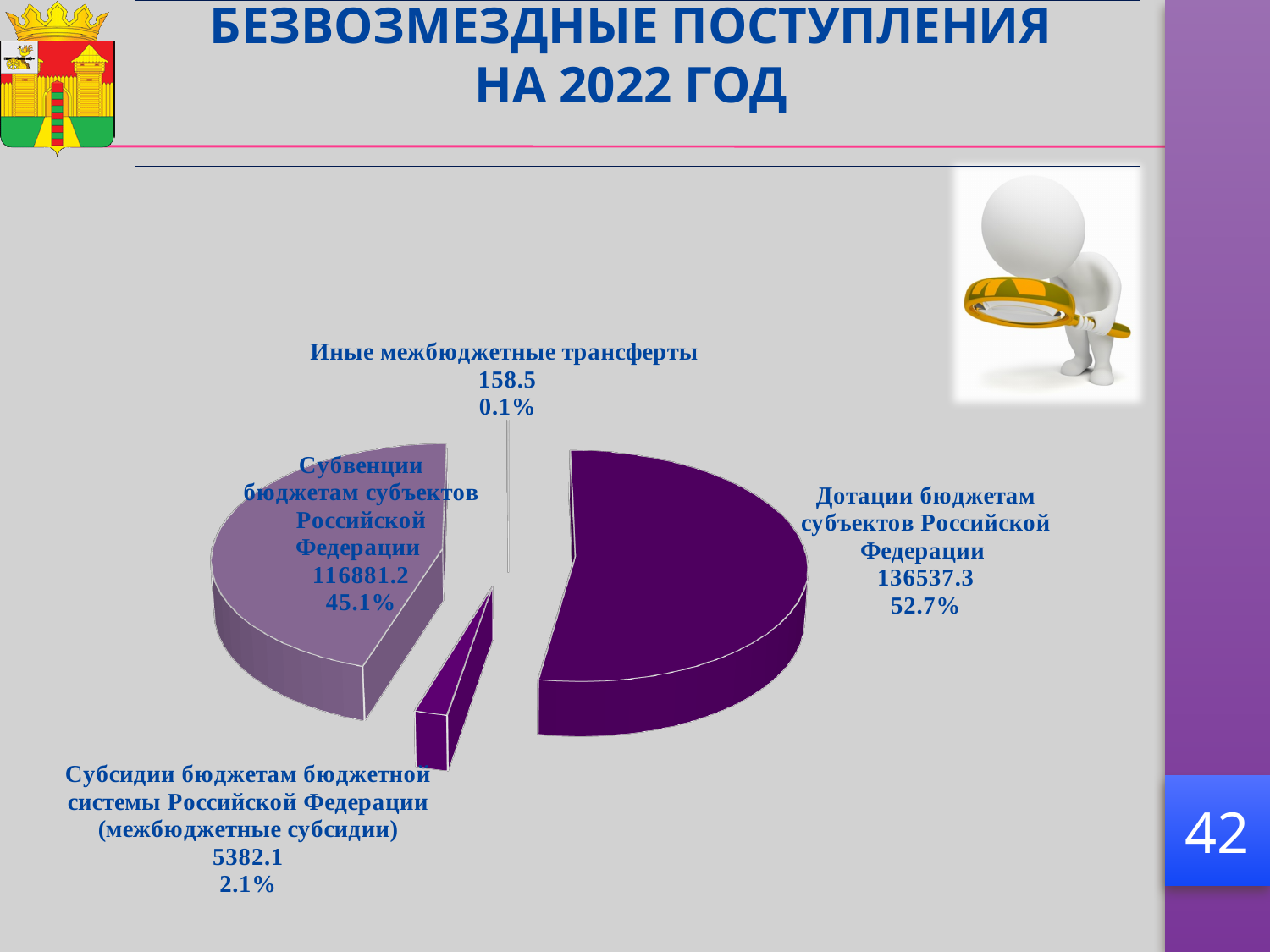
Which is larger: the value for Субсидии бюджетам бюджетной системы Российской Федерации (межбюджетные субсидии) or Иные межбюджетные трансферты? Субсидии бюджетам бюджетной системы Российской Федерации (межбюджетные субсидии) What is the difference between the values for Дотации бюджетам субъектов Российской Федерации and Субвенции бюджетам субъектов Российской Федерации? 19656.1 Which category has the largest slice of the pie? Дотации бюджетам субъектов Российской Федерации How many slices does the pie chart have? 4 What share of the pie does Иные межбюджетные трансферты represent? 0.1% What is the value for Дотации бюджетам субъектов Российской Федерации? 136537.3 Which category has the smallest slice of the pie? Иные межбюджетные трансферты What kind of chart is shown on the slide? pie chart What is the value for Субсидии бюджетам бюджетной системы Российской Федерации (межбюджетные субсидии)? 5382.1 What share of the pie does Субвенции бюджетам субъектов Российской Федерации represent? 45.1% What is the title of the slide containing the pie chart? БЕЗВОЗМЕЗДНЫЕ ПОСТУПЛЕНИЯ НА 2022 ГОД What share of the pie does Дотации бюджетам субъектов Российской Федерации represent? 52.7%